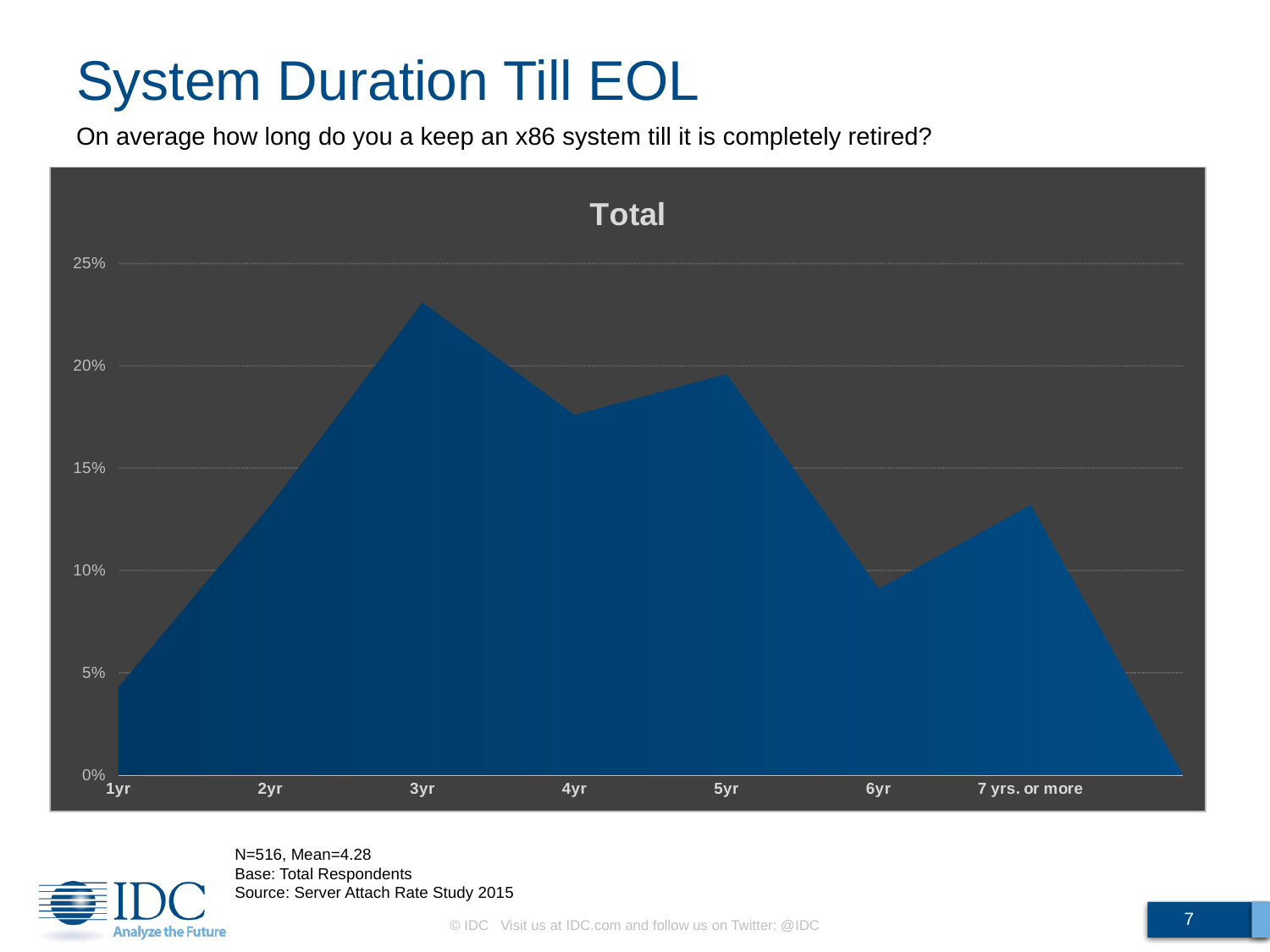
Which is larger, the value for 2yr or the value for 6yr? 2yr Which category has the lowest value in the chart? 1yr Do the values rise or fall from 1yr to 3yr? rise What is the title shown above the chart? Total How many categories are shown on the x axis of the chart? 7 Is the value for 3yr greater or less than 20%? greater Is the value for 1yr greater or less than 5%? less Which is larger, the value for 5yr or the value for 4yr? 5yr What kind of chart is shown on the slide? area chart Which category has the highest value in the chart? 3yr Is the value for 6yr greater or less than 10%? less